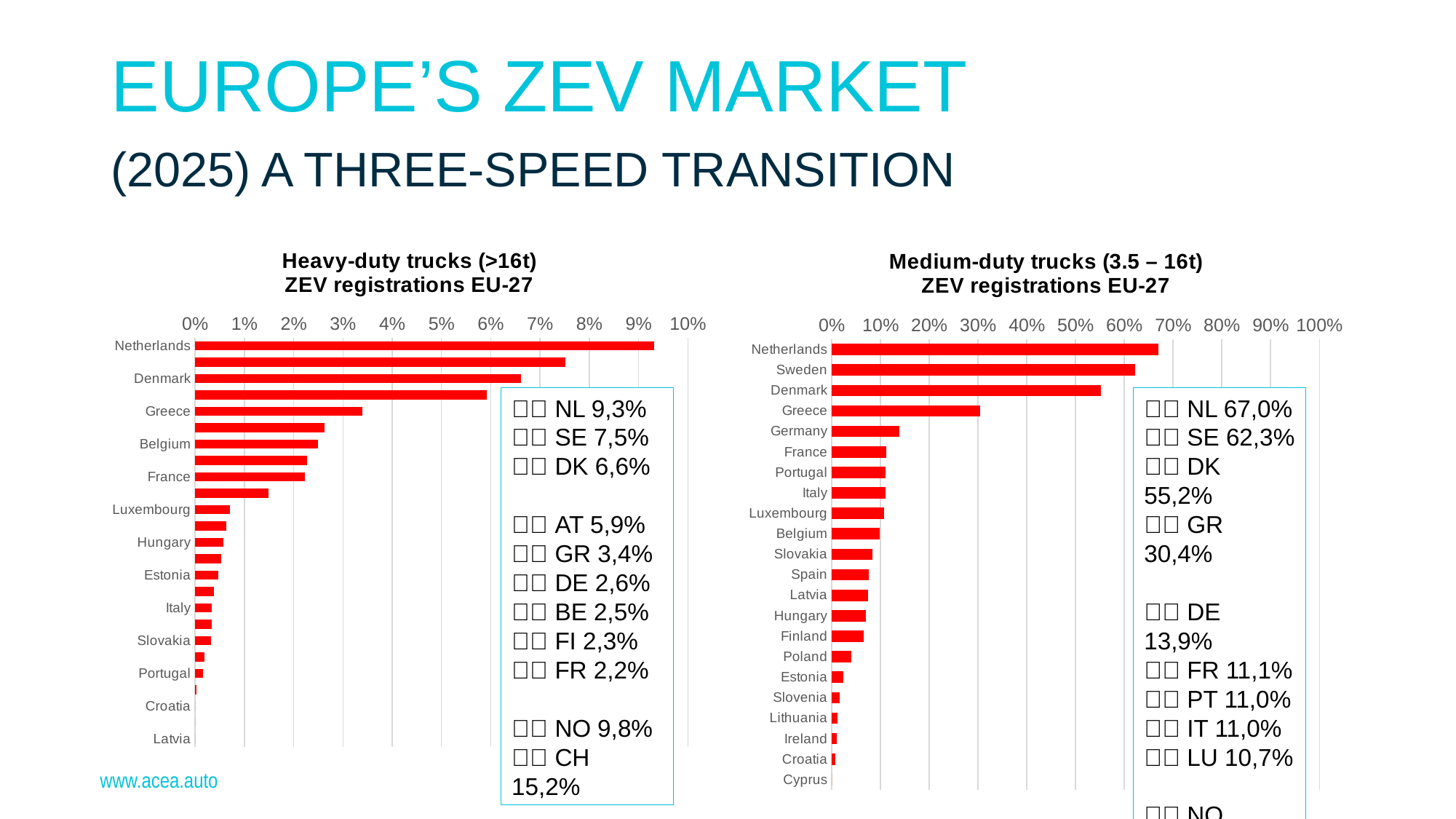
In the 'Heavy-duty trucks (>16t)' chart, what is the ZEV registration share for Denmark? 6,6% In the 'Heavy-duty trucks (>16t)' chart, what is the difference between the Netherlands and Denmark shares? 2,7% In the 'Medium-duty trucks (3.5 – 16t)' chart, is the value for Germany greater or less than 20%? less In the 'Heavy-duty trucks (>16t)' chart, which is larger, Greece or Belgium? Greece What kind of chart is the 'Heavy-duty trucks (>16t) ZEV registrations EU-27' chart? Bar chart In the 'Heavy-duty trucks (>16t)' chart, which country has the highest ZEV registration share? Netherlands In the 'Medium-duty trucks (3.5 – 16t)' chart, which country has the highest ZEV registration share? Netherlands In the 'Medium-duty trucks (3.5 – 16t)' chart, what is the ZEV registration share for Sweden? 62,3% In the 'Medium-duty trucks (3.5 – 16t)' chart, how many countries are listed on the y axis? 22 In the 'Medium-duty trucks (3.5 – 16t)' chart, which country has the lowest ZEV registration share? Cyprus In the 'Heavy-duty trucks (>16t)' chart, what is the ZEV registration share for the Netherlands? 9,3% In the 'Heavy-duty trucks (>16t)' chart, is the value for Belgium greater or less than 3%? less